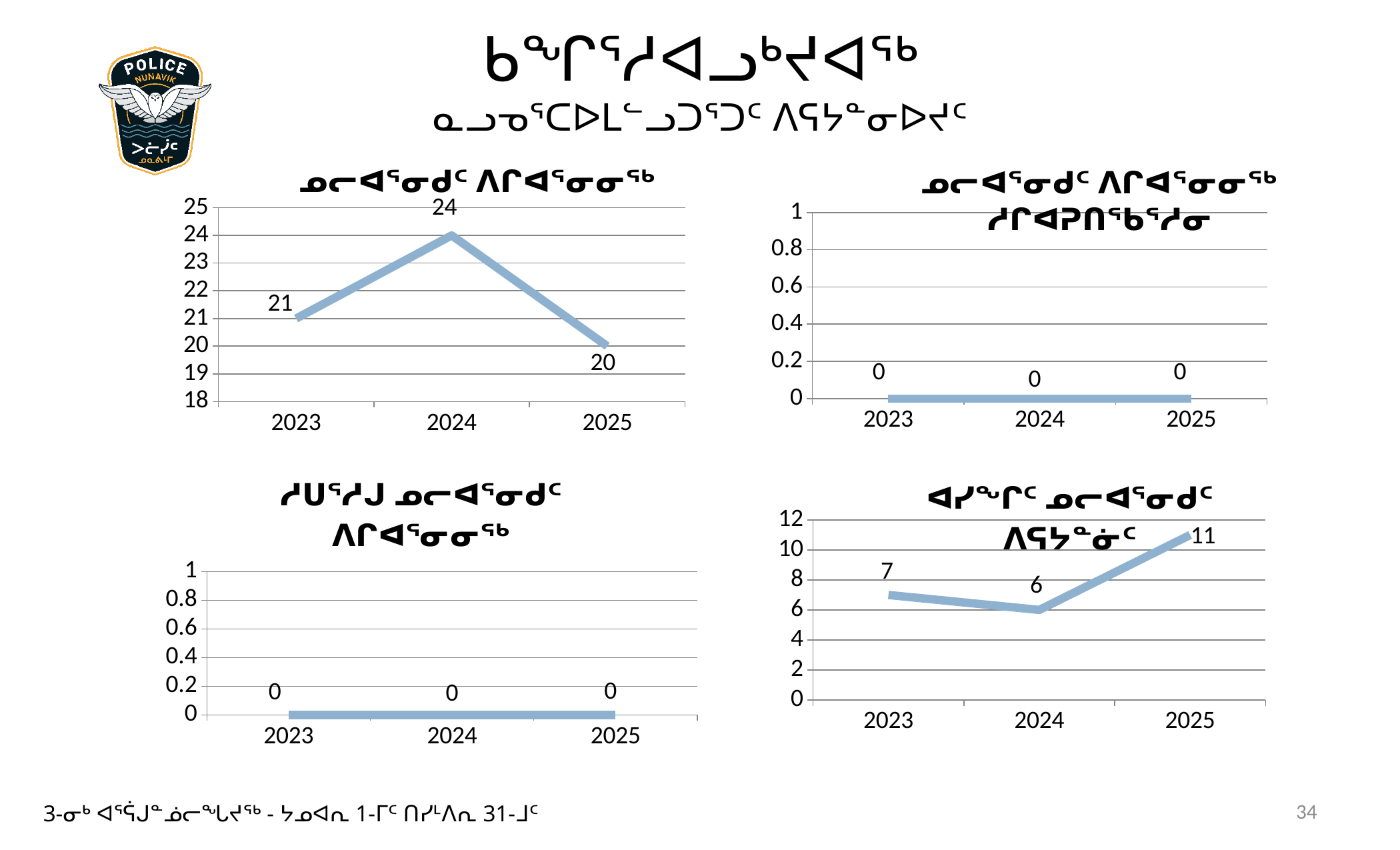
In the top-right chart, what is the value for 2024? 0 In the bottom-right chart, which year has the highest value? 2025 In the top-left chart, what is the value for 2024? 24 In the top-left chart, what is the value for 2025? 20 In the top-left chart, which year has the highest value? 2024 How many years are shown on the x axis of the bottom-left chart? 3 In the bottom-right chart, is the value for 2023 or 2024 larger? 2023 In the bottom-right chart, what is the value for 2023? 7 In the bottom-right chart, what is the difference between the 2025 and 2024 values? 5 What kind of chart is the bottom-right chart? line chart In the top-left chart, what is the difference between the 2024 and 2023 values? 3 In the top-left chart, which year has the lowest value? 2025